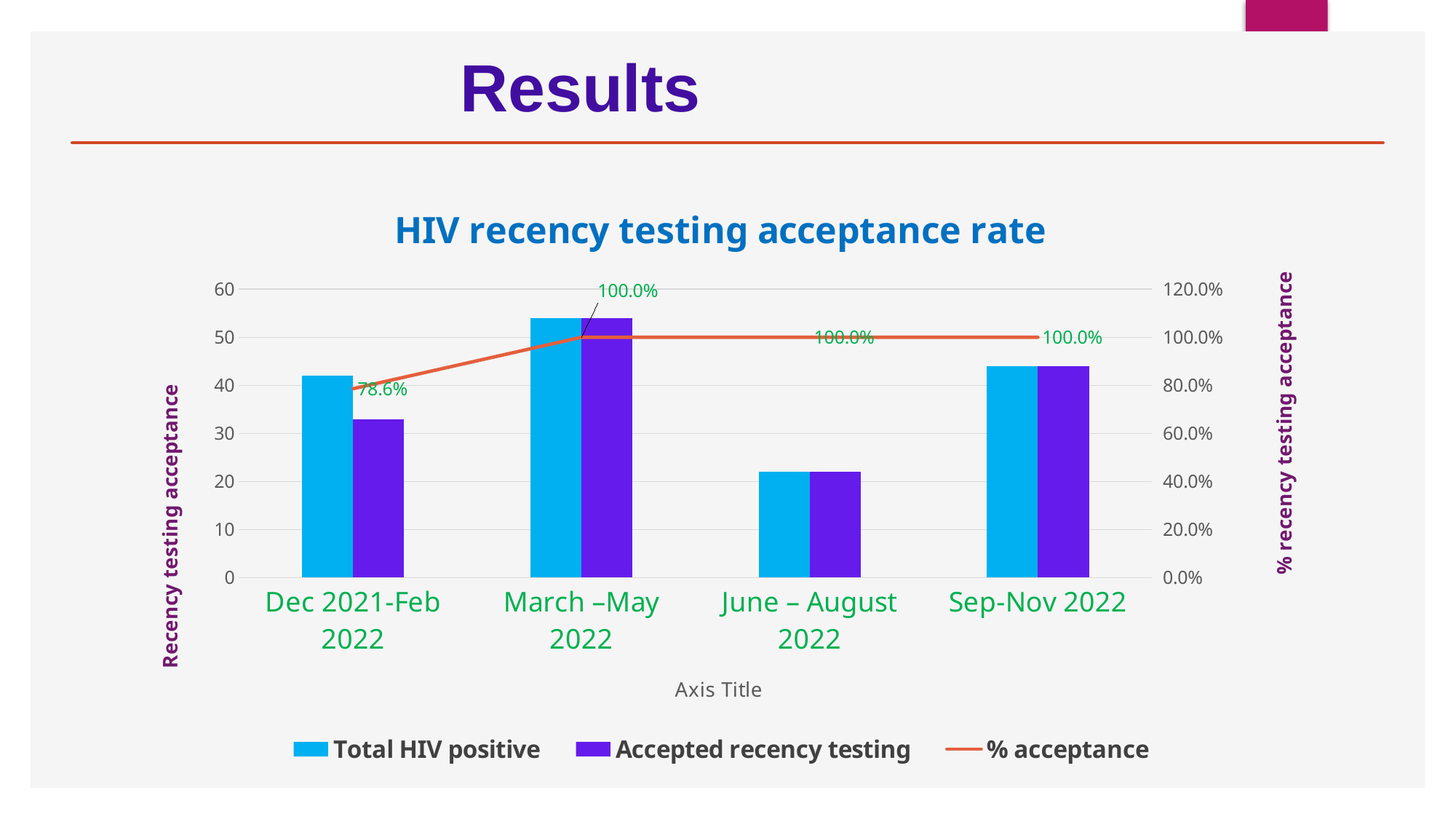
Is the Accepted recency testing value for June – August 2022 greater or less than 30? less Which period has the highest Total HIV positive bar? March –May 2022 Is the Total HIV positive value for Dec 2021-Feb 2022 larger than the Total HIV positive value for June – August 2022? Yes What is the title of the chart? HIV recency testing acceptance rate What is the % acceptance value for March –May 2022? 100.0% Is the Total HIV positive value for March –May 2022 greater or less than 50? greater Which period has the lowest % acceptance? Dec 2021-Feb 2022 What is the % acceptance value for Dec 2021-Feb 2022? 78.6% How many series does the legend list? 3 What is the % acceptance value for Sep-Nov 2022? 100.0% How many time periods are shown on the x axis? 4 Which period has the lowest Total HIV positive bar? June – August 2022